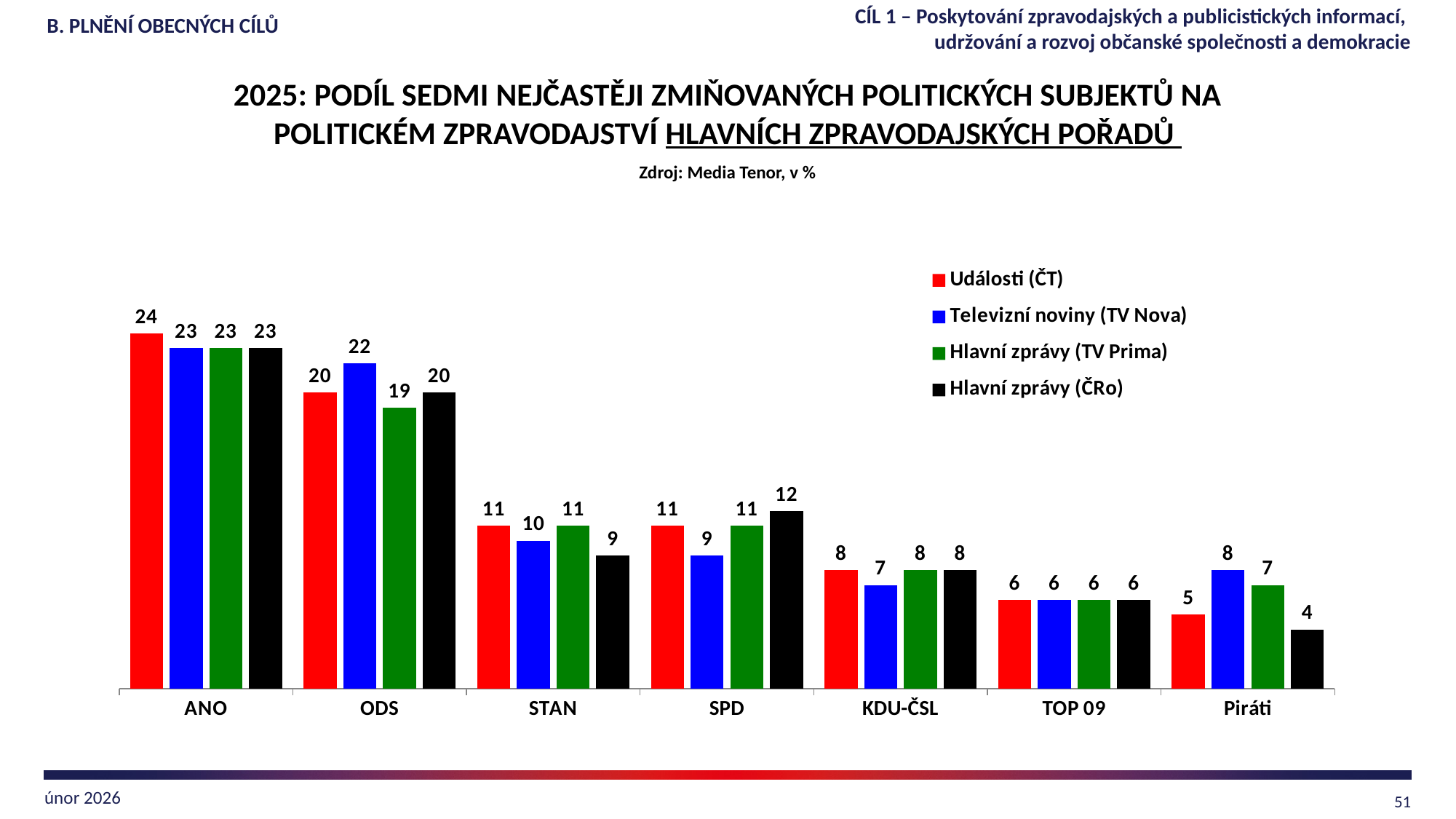
What is the value for Piráti in the Hlavní zprávy (ČRo) series? 4 How many categories are shown on the x axis? 7 What colour represents the Hlavní zprávy (TV Prima) series? green What kind of chart is shown on the slide? bar chart How many series does the legend list? 4 What is the difference between the Události (ČT) value for ANO and the Události (ČT) value for ODS? 4 What is the value for ANO in the Události (ČT) series? 24 Which is larger for SPD: the Televizní noviny (TV Nova) value or the Hlavní zprávy (ČRo) value? Hlavní zprávy (ČRo) What is the value for ODS in the Televizní noviny (TV Nova) series? 22 Do the Události (ČT) values generally rise or fall from ANO to Piráti along the x axis? fall Which category has the highest value in the Hlavní zprávy (TV Prima) series? ANO Which category has the lowest value in the Události (ČT) series? Piráti